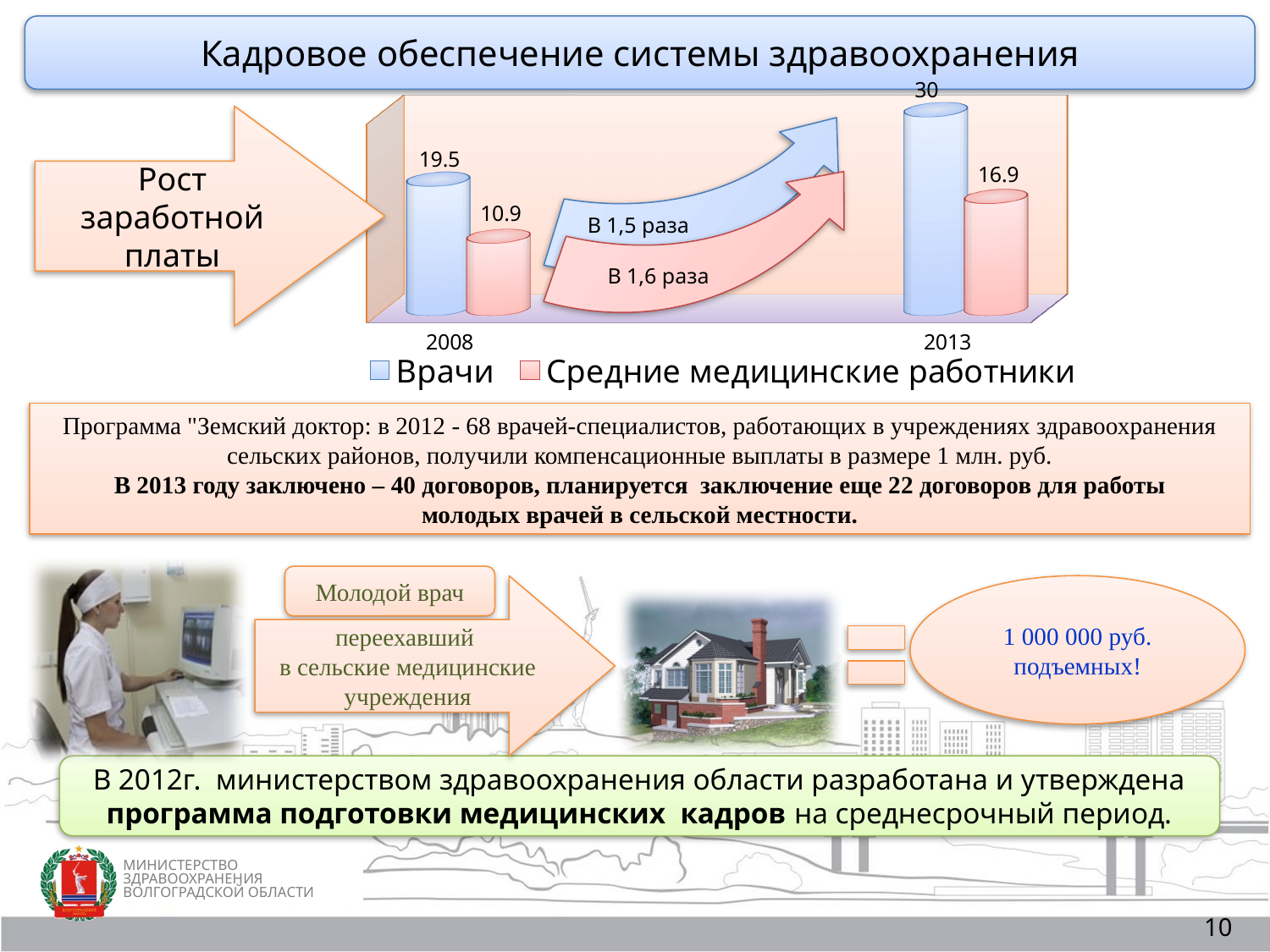
How many series does the chart legend list? 2 In which year is the value for Врачи highest? 2013 Which is larger in 2008: Врачи or Средние медицинские работники? Врачи What is the value for Врачи in 2008? 19.5 What is the difference between Врачи and Средние медицинские работники in 2013? 13.1 What is the value for Врачи in 2013? 30 What is the difference between the Врачи values for 2013 and 2008? 10.5 Which series has the lowest value in 2008? Средние медицинские работники What is the value for Средние медицинские работники in 2013? 16.9 What kind of chart is shown on the slide? Bar chart How many years are shown on the x axis of the chart? 2 What is the value for Средние медицинские работники in 2008? 10.9